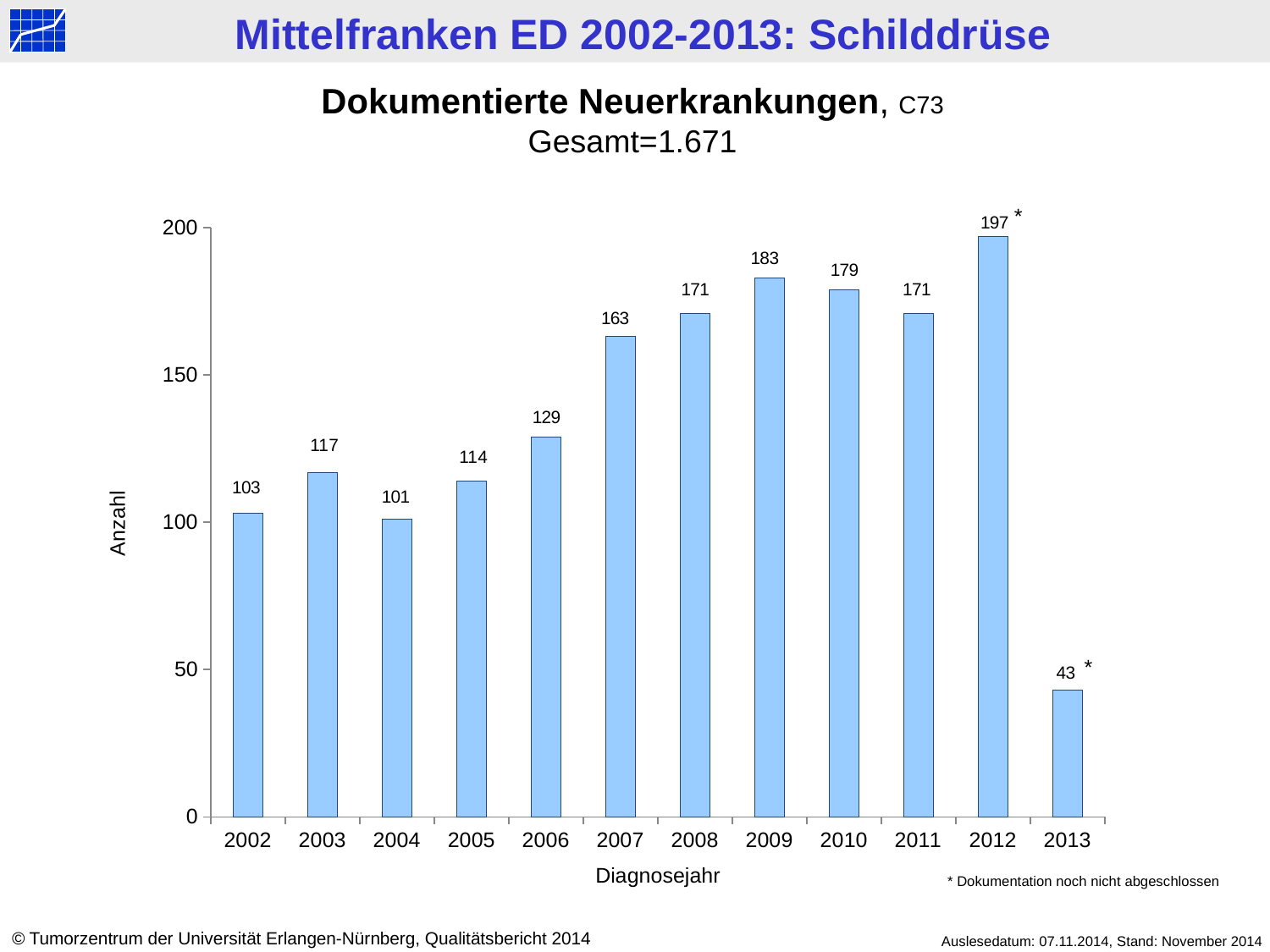
Which year has the highest value? 2012 How many years are shown on the x axis? 12 What is the value for 2009? 183 What is the label of the y axis? Anzahl What is the value for 2013? 43 Do the values rise or fall from 2004 to 2009? rise Which year has the lowest value? 2013 What is the difference between the values for 2012 and 2011? 26 Is the value for 2006 greater or less than 150? less What kind of chart is shown? bar chart What is the value for 2004? 101 Which is larger, the value for 2007 or the value for 2010? 2010